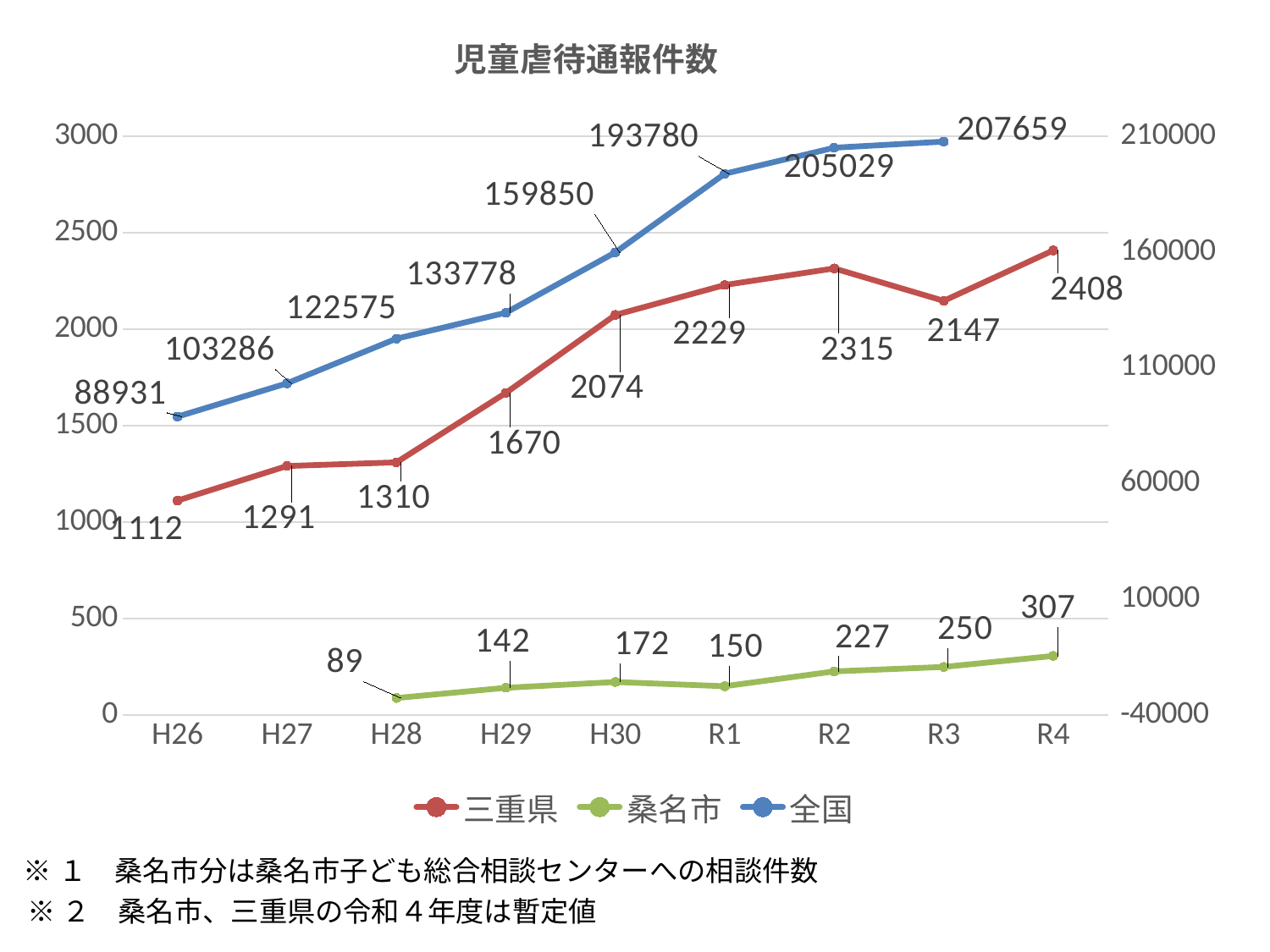
What is the value for 桑名市 in R2? 227 How many series does the legend list? 3 What kind of chart is this? line chart Which is larger for 全国: the value in H29 or the value in H28? H29 What is the value for 三重県 in H30? 2074 What is the title of the chart? 児童虐待通報件数 In which year is the value for 三重県 highest? R4 How many years are shown on the x axis? 9 What is the difference between the 三重県 values in R4 and R3? 261 In which year is the value for 桑名市 lowest? H28